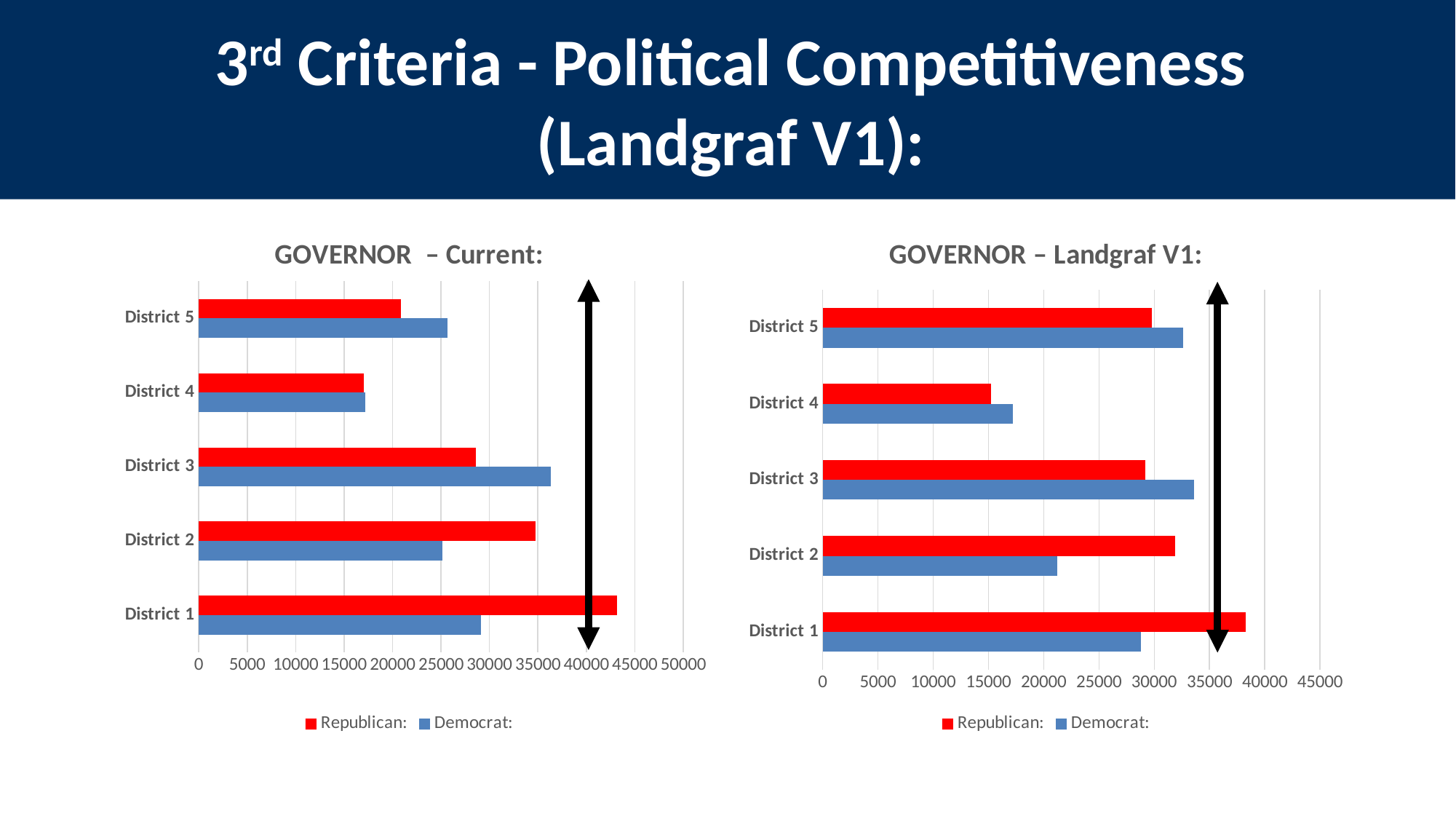
On the 'GOVERNOR – Current:' chart, which district has the lowest Democrat value? District 4 On the 'GOVERNOR – Landgraf V1:' chart, which is larger for District 2, the Republican or the Democrat value? Republican On the 'GOVERNOR – Landgraf V1:' chart, which district has the lowest Republican value? District 4 On the 'GOVERNOR – Current:' chart, which is larger for District 3, the Republican or the Democrat value? Democrat On the 'GOVERNOR – Landgraf V1:' chart, is the Democrat value for District 2 greater or less than 25000? less How many series does the legend of the 'GOVERNOR – Landgraf V1:' chart list? 2 What are the two legend entries on the 'GOVERNOR – Current:' chart? Republican and Democrat How many districts are shown on the 'GOVERNOR – Current:' chart? 5 On the 'GOVERNOR – Current:' chart, is the Republican value for District 1 greater or less than 40000? greater On the 'GOVERNOR – Current:' chart, is the Democrat value for District 3 greater or less than 30000? greater On the 'GOVERNOR – Current:' chart, which district has the highest Republican value? District 1 What kind of chart is the 'GOVERNOR – Current:' chart? bar chart